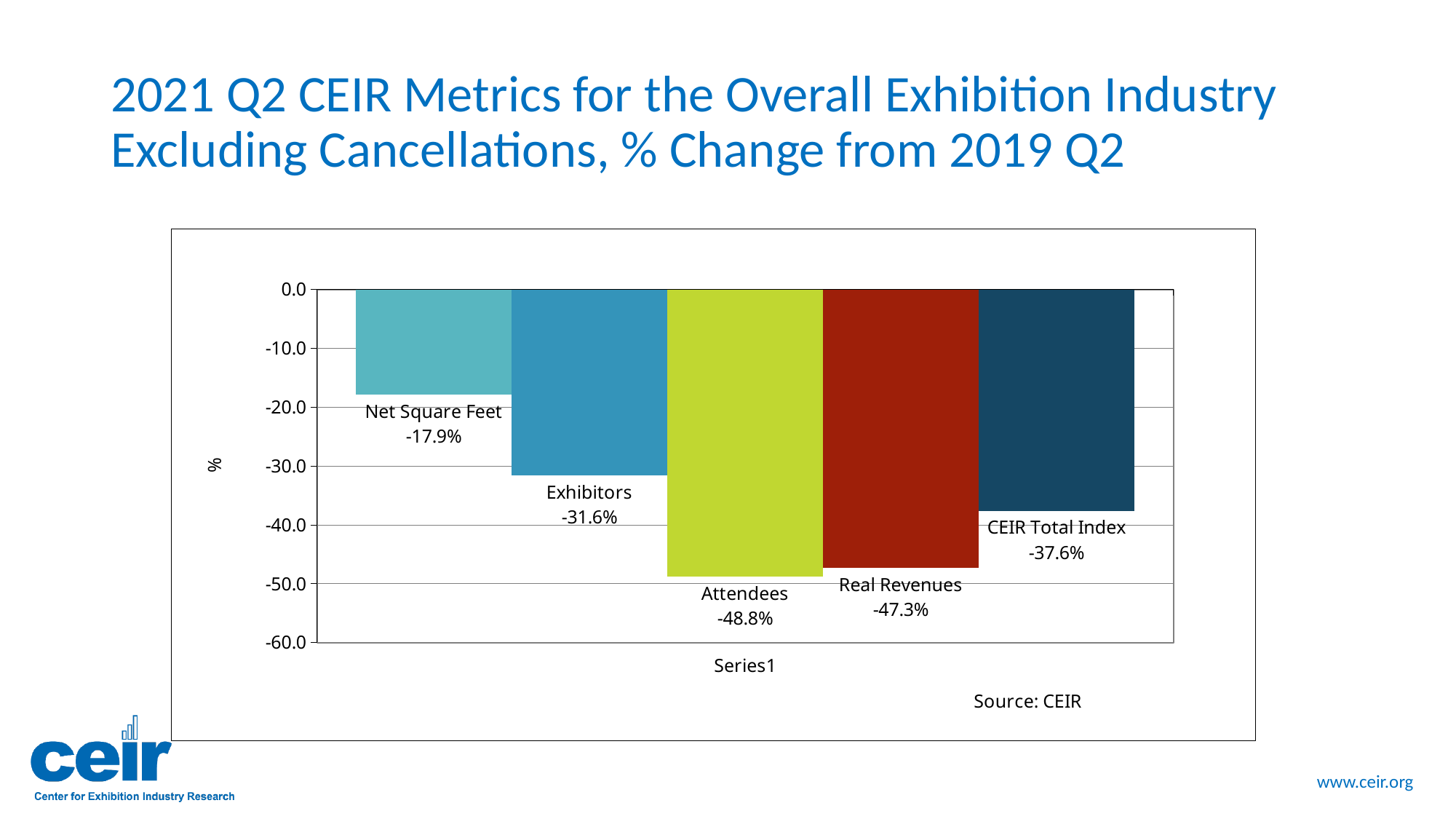
Which category has the highest value (smallest decline)? Net Square Feet What is the value for Attendees? -48.8% What is the value for Exhibitors? -31.6% What is the value for CEIR Total Index? -37.6% What is the difference between the values for Net Square Feet and Exhibitors? 13.7 percentage points Which category has the lowest value (largest decline)? Attendees How many categories are plotted in the chart? 5 What is the value for Real Revenues? -47.3% What kind of chart is shown on the slide? Bar chart What is the value for Net Square Feet? -17.9% What is the source cited below the chart? CEIR Which is larger, the value for Exhibitors or the value for CEIR Total Index? Exhibitors